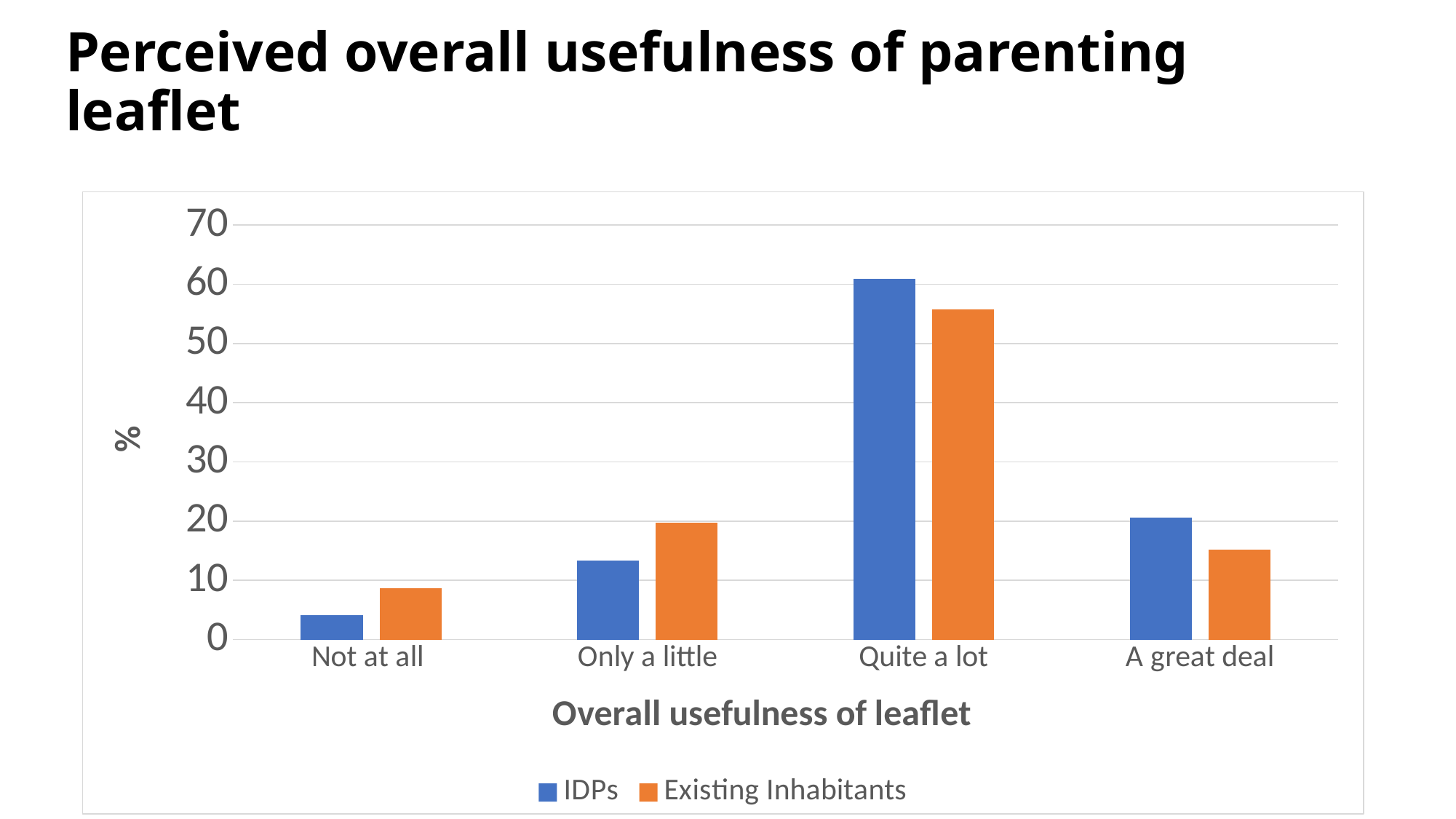
Which category has the highest value for IDPs? Quite a lot For 'Only a little', which series has the larger value, IDPs or Existing Inhabitants? Existing Inhabitants Which category has the lowest value for IDPs? Not at all Which category has the lowest value for Existing Inhabitants? Not at all What is the label of the x axis? Overall usefulness of leaflet What kind of chart is shown on the slide? bar chart How many categories are shown on the x axis? 4 Is the value for IDPs in 'Not at all' greater or less than 10? less Is the value for Existing Inhabitants in 'A great deal' greater or less than 20? less For 'Quite a lot', which series has the larger value, IDPs or Existing Inhabitants? IDPs Is the value for IDPs in 'Quite a lot' greater or less than 50? greater How many series does the legend list? 2